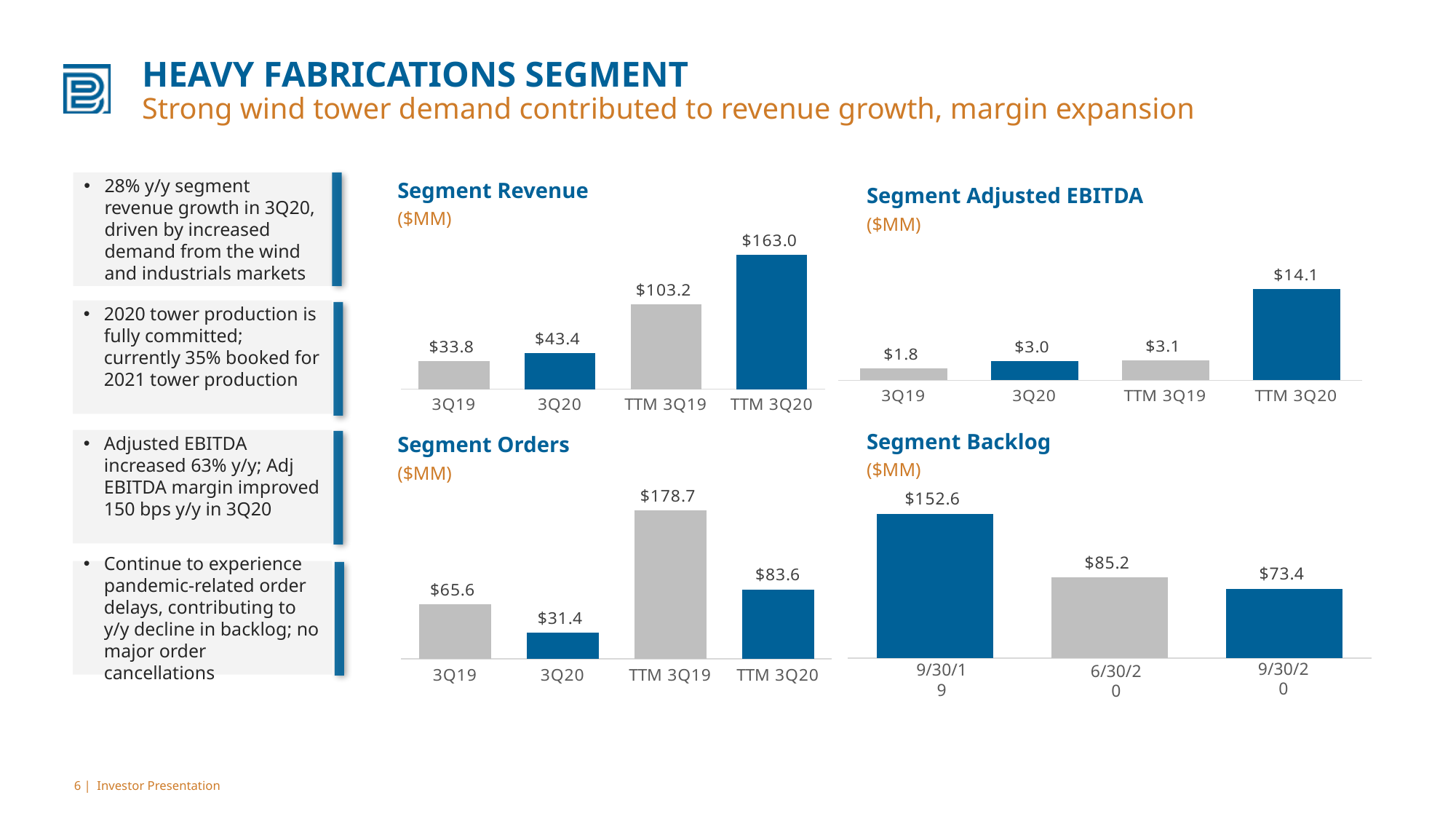
In the Segment Backlog chart, how many bars are plotted? 3 In the Segment Backlog chart, what is the difference between the 9/30/19 and 9/30/20 values? $79.2 In the Segment Adjusted EBITDA chart, which category has the highest value? TTM 3Q20 In the Segment Adjusted EBITDA chart, which category has the lowest value? 3Q19 In the Segment Backlog chart, do the values rise or fall from left to right? fall In the Segment Revenue chart, what is the value for 3Q19? $33.8 In the Segment Orders chart, which is larger, the value for 3Q19 or the value for 3Q20? 3Q19 What kind of chart is the Segment Adjusted EBITDA chart? bar chart In the Segment Orders chart, what is the value for TTM 3Q19? $178.7 In the Segment Revenue chart, what is the value for TTM 3Q20? $163.0 In the Segment Backlog chart, what is the value for 6/30/20? $85.2 In the Segment Revenue chart, what is the difference between the 3Q20 and 3Q19 values? $9.6